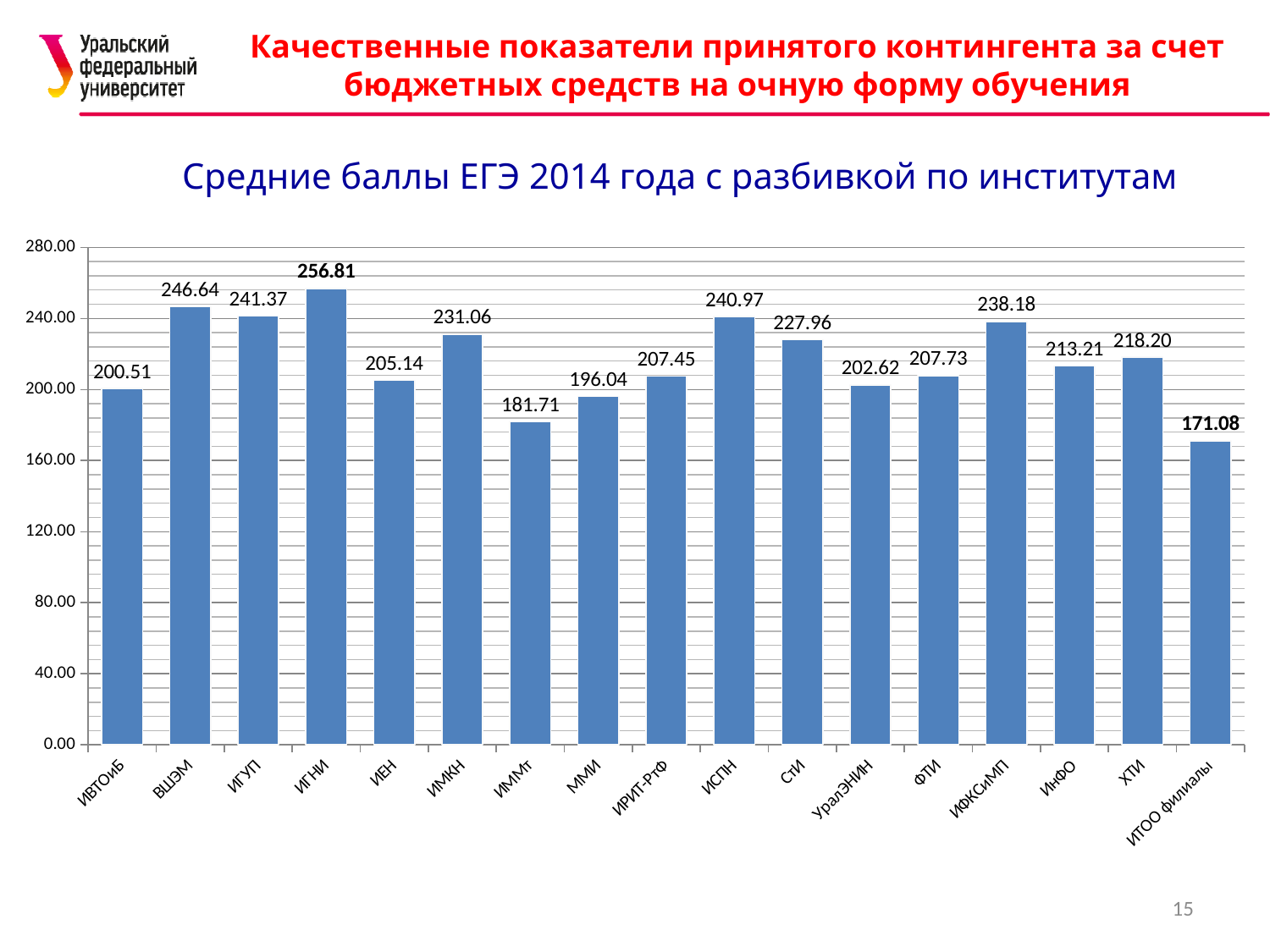
Which category has the lowest value on the chart? ИТОО филиалы What is the difference between the values for ВШЭМ and ИГУП? 5.27 Which has a higher value, ИСПН or СТИ? ИСПН How many institutes (categories) are shown on the chart? 17 Which institute has the highest average ЕГЭ score? ИГНИ What is the difference between the values for ИГНИ and ИТОО филиалы? 85.73 What type of chart is shown on the slide? Bar chart Is the value for ММИ greater or less than 200.00? less What value is shown for ИММт? 181.71 What is the value for ИФКСиМП? 238.18 What value is shown for ХТИ? 218.20 What is the average ЕГЭ score shown for ИГНИ? 256.81